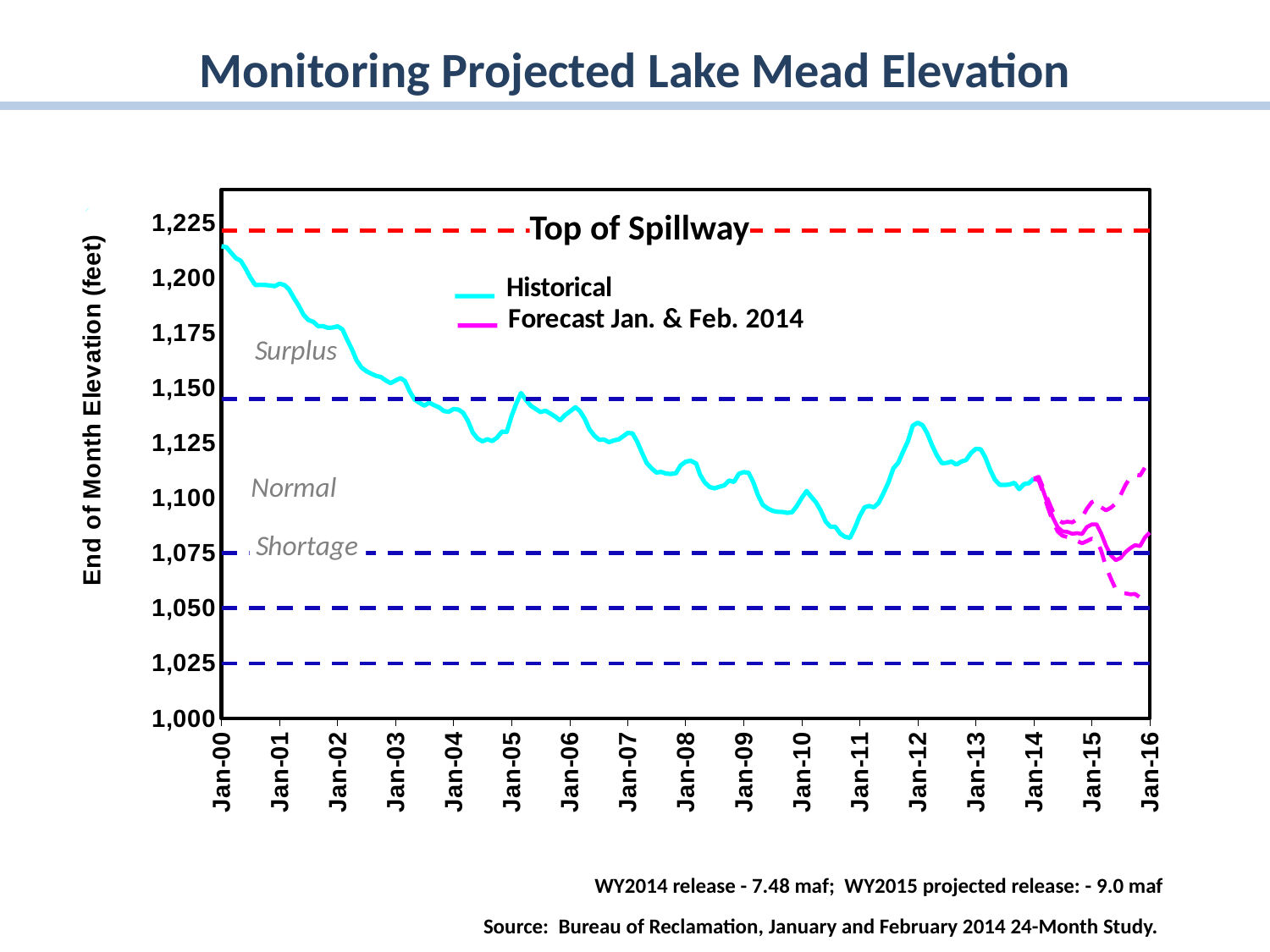
Is the Historical elevation at Jan-04 greater or less than 1,150? less Which is higher, the Historical elevation at Jan-00 or at Jan-14? Jan-00 What are the two series named in the legend? Historical; Forecast Jan. & Feb. 2014 Is the Historical elevation at Jan-12 greater or less than 1,125? greater Is the Historical elevation at Jan-00 greater or less than 1,200? greater What is the label of the y axis? End of Month Elevation (feet) At which x-axis date does the Historical line reach its highest value? Jan-00 What kind of chart is shown on the slide? Line chart How many series does the chart legend list? 2 Which is higher, the Historical elevation at Jan-12 or at Jan-11? Jan-12 Does the Historical line generally rise or fall from Jan-00 to Jan-14? Fall